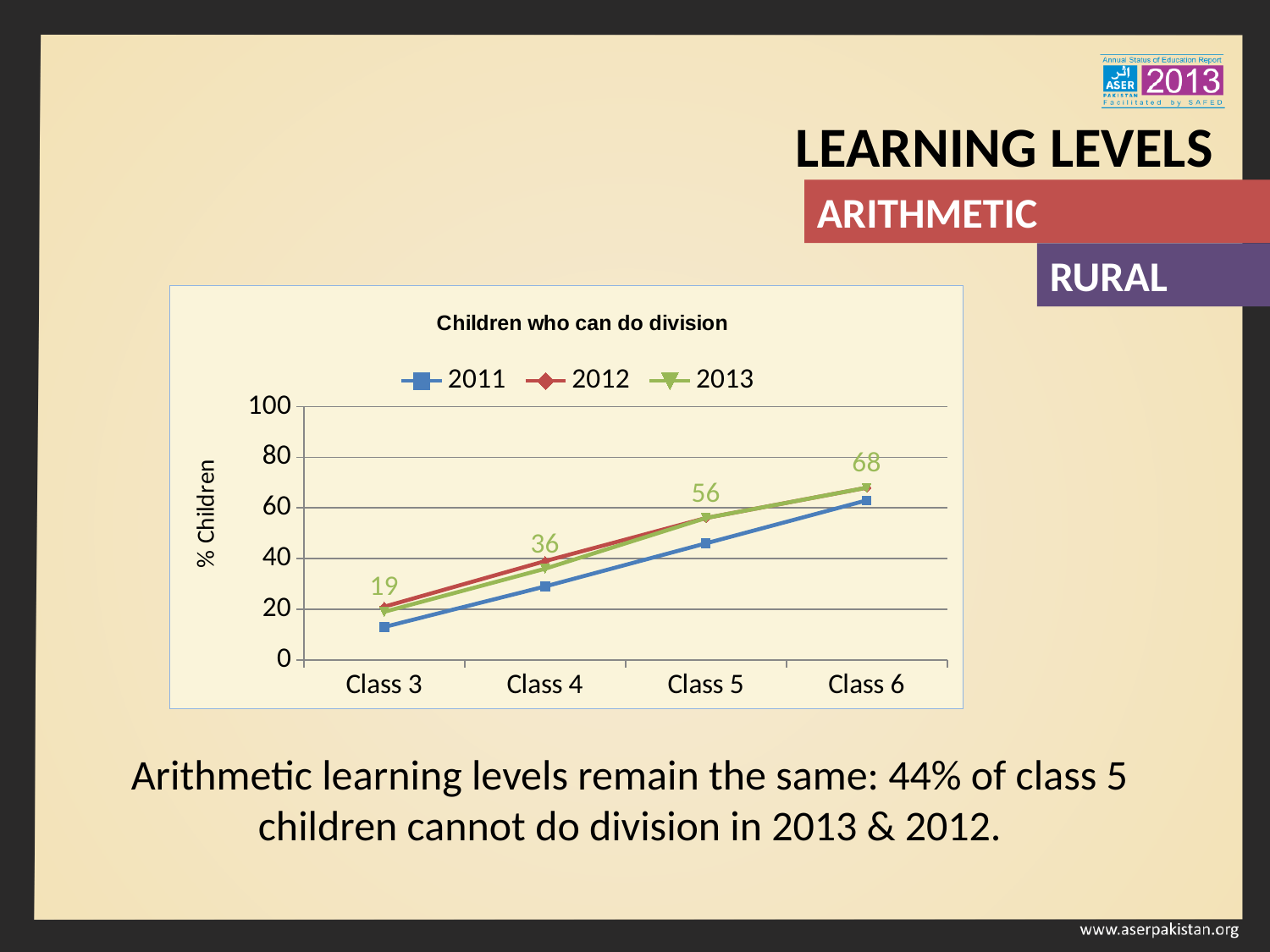
What is the value for Class 5 in the 2013 series? 56 Do the 2013 values rise or fall from Class 3 to Class 6? rise How many series does the legend list? 3 Which class has the highest value in the 2013 series? Class 6 What is the value for Class 4 in the 2013 series? 36 Is the 2011 value for Class 6 greater or less than 60? greater What is the value for Class 6 in the 2013 series? 68 Which class has the lowest value in the 2013 series? Class 3 What is the difference between the 2013 values for Class 6 and Class 3? 49 What kind of chart is shown on the slide? line chart Is the 2011 value for Class 3 greater or less than 20? less What is the value for Class 3 in the 2013 series? 19